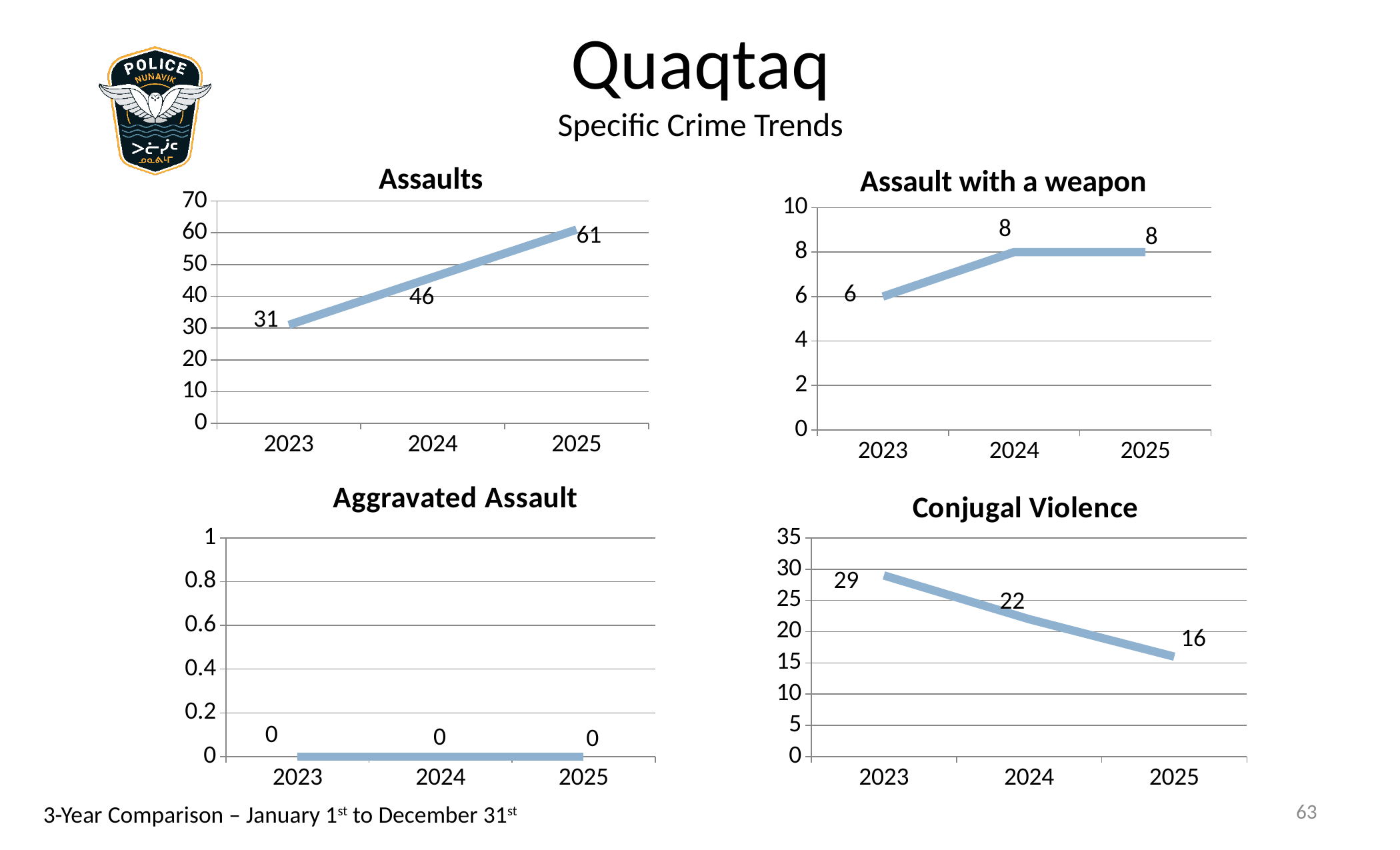
In the Assaults chart, what is the difference between the 2025 and 2023 values? 30 In the Conjugal Violence chart, which is larger, the value for 2023 or the value for 2025? 2023 In the Conjugal Violence chart, do the values rise or fall from 2023 to 2025? fall What kind of chart is the Assaults chart? line chart In the Assaults chart, which year has the highest value? 2025 In the Assault with a weapon chart, what is the value for 2023? 6 In the Assaults chart, what is the value for 2024? 46 How many years are plotted in the Conjugal Violence chart? 3 In the Conjugal Violence chart, what is the value for 2024? 22 In the Aggravated Assault chart, what is the value for 2025? 0 In the Assault with a weapon chart, which year has the lowest value? 2023 In the Assaults chart, do the values rise or fall from 2023 to 2025? rise